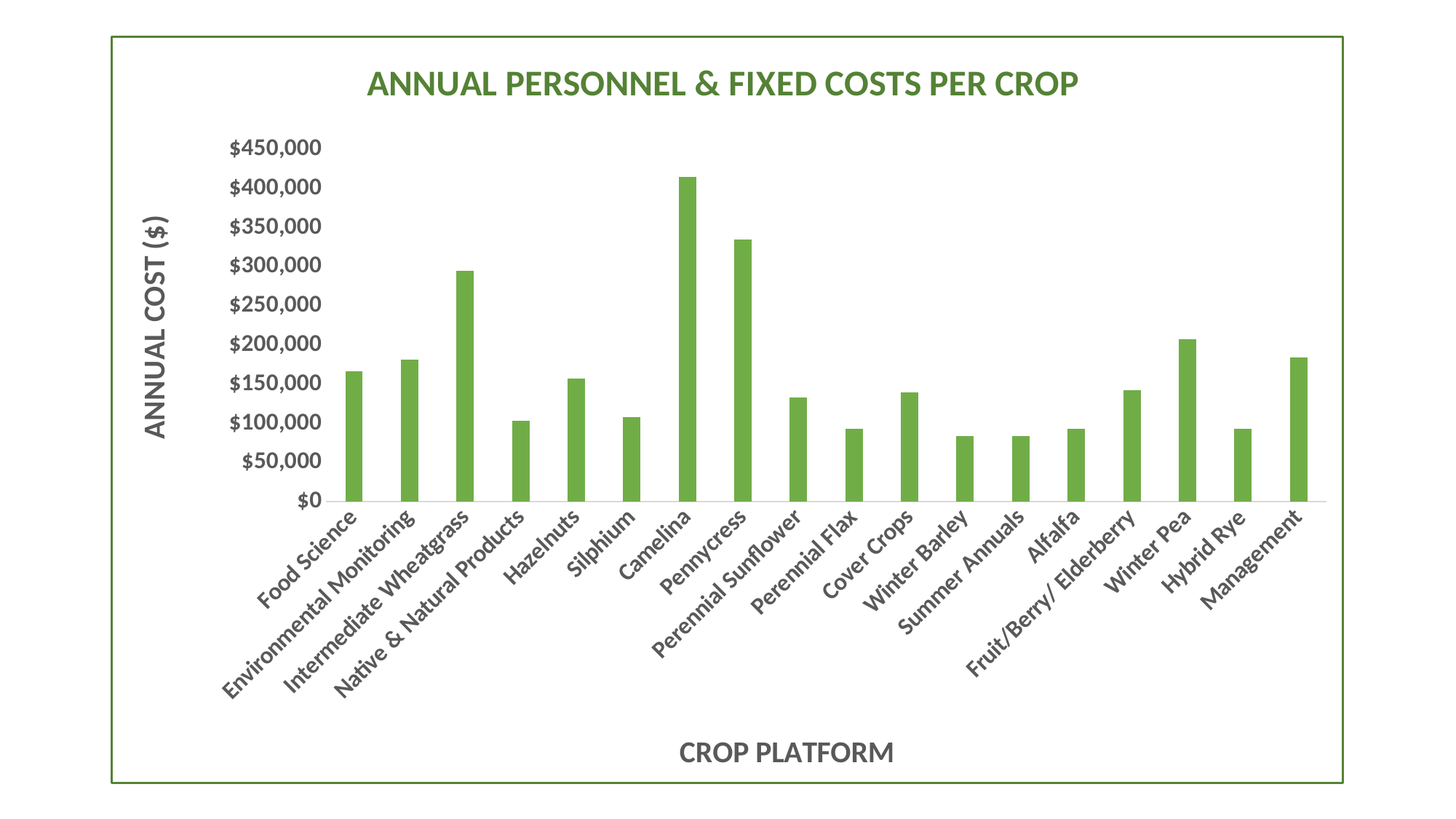
How many crop platforms are shown on the x axis? 18 What is the title of the chart? ANNUAL PERSONNEL & FIXED COSTS PER CROP Is the value for Management greater or less than $200,000? less Is the value for Camelina greater or less than $400,000? greater Which crop platform has the highest annual cost? Camelina Is the value for Perennial Sunflower greater or less than $150,000? less Which has the higher annual cost, Intermediate Wheatgrass or Winter Pea? Intermediate Wheatgrass Which has the higher annual cost, Camelina or Pennycress? Camelina What kind of chart is shown on the slide? bar chart